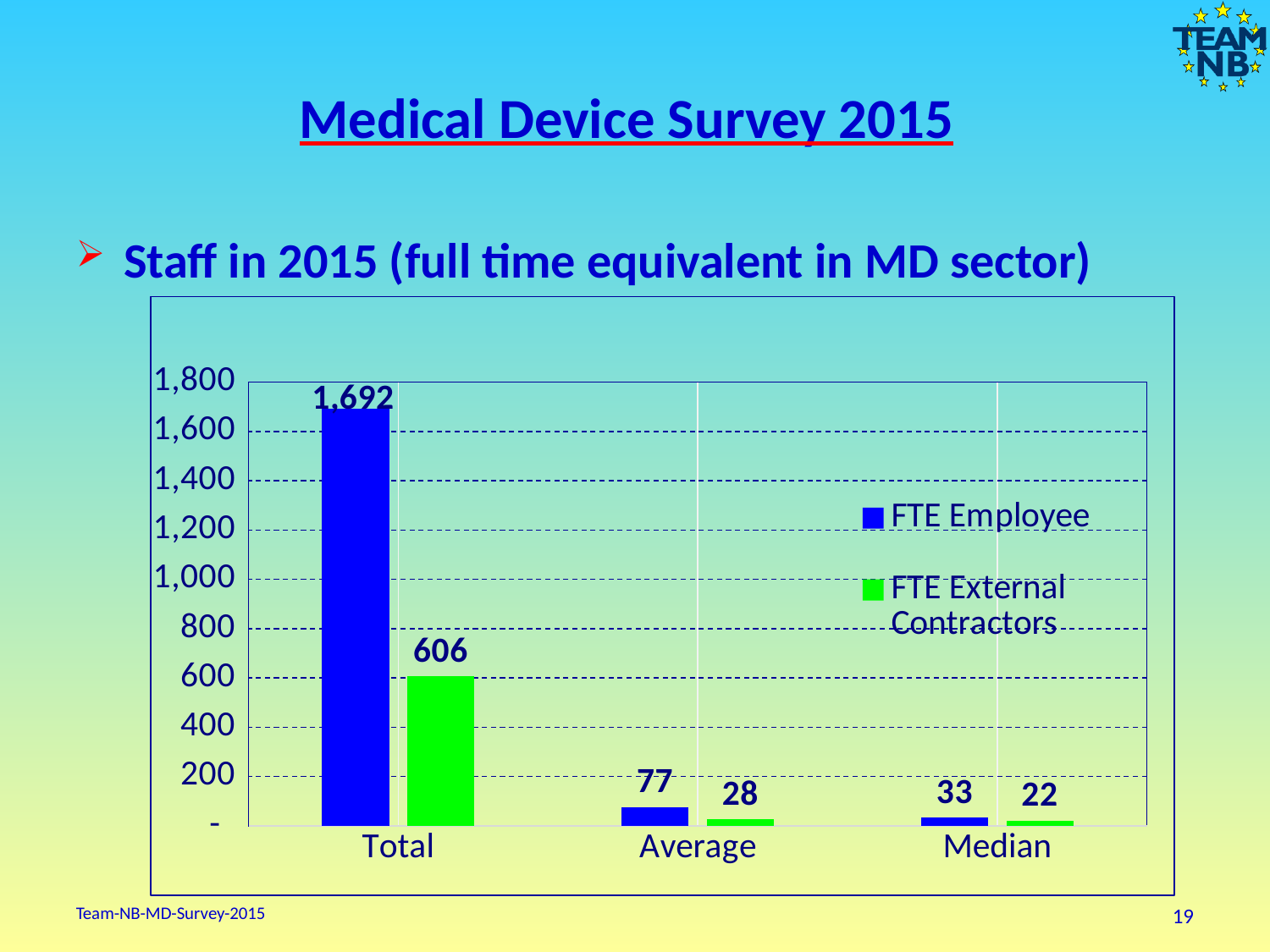
What kind of chart is shown on the slide? Bar chart Which is larger for Average: FTE Employee or FTE External Contractors? FTE Employee What is the FTE Employee value for Average? 77 What is the FTE External Contractors value for Total? 606 Which category has the lowest FTE External Contractors value? Median Which category has the highest FTE Employee value? Total How many categories are shown on the x axis? 3 What is the difference between the FTE Employee values for Average and Median? 44 How many series does the legend list? 2 What is the difference between the FTE Employee and FTE External Contractors values for Total? 1,086 What is the FTE External Contractors value for Median? 22 What is the FTE Employee value for Total? 1,692